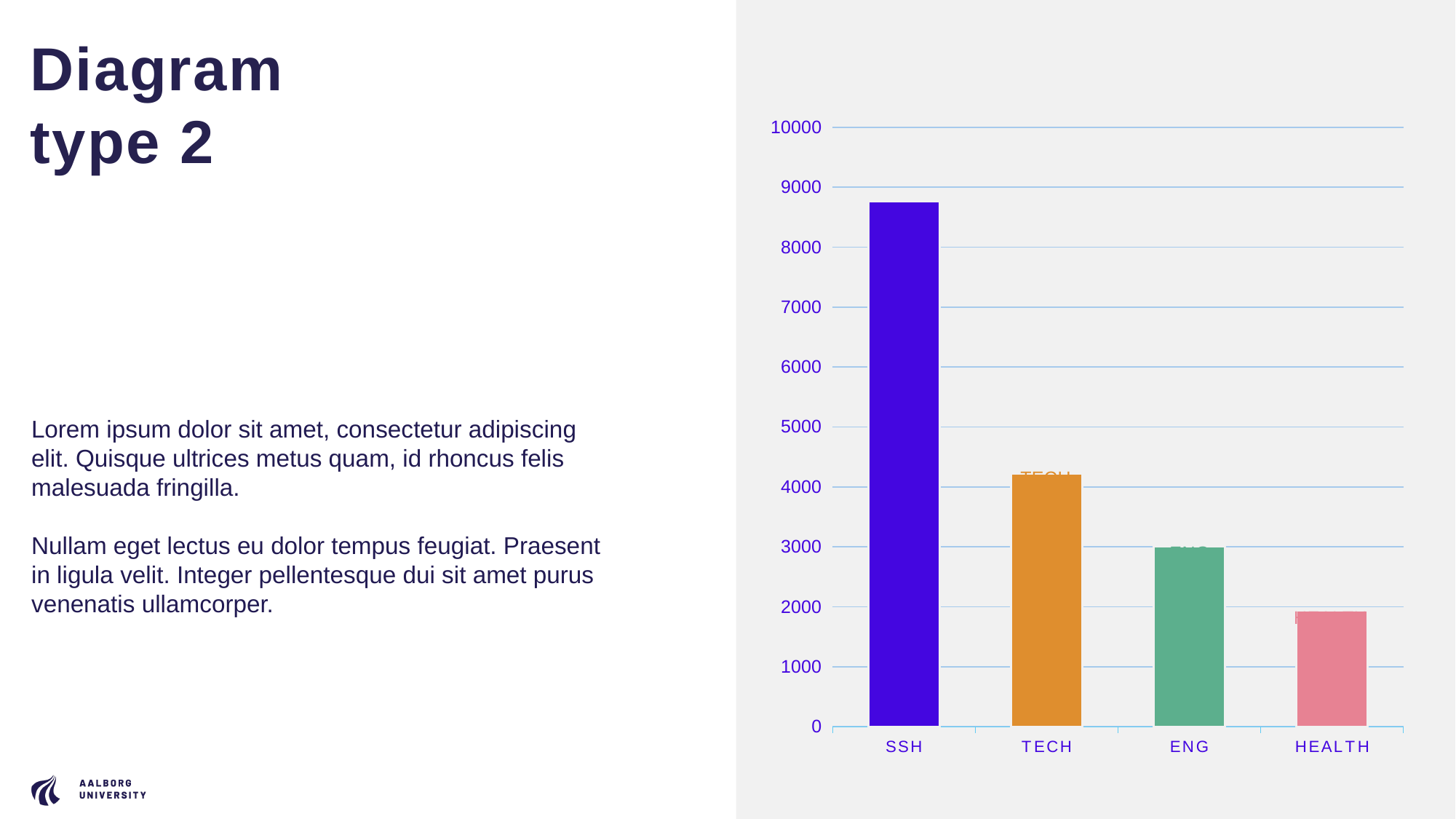
Is the value for TECH greater or less than 4000? greater Is the value for SSH greater or less than 8000? greater What is the highest value shown on the chart's vertical axis? 10000 What colour is the bar for SSH? purple What kind of chart is shown on the slide? bar chart Which category has the lowest bar in the chart? HEALTH Which is larger, the value for TECH or the value for ENG? TECH Do the bar values rise or fall from left to right along the x axis? fall How many categories are shown on the x axis of the chart? 4 Which category has the highest bar in the chart? SSH